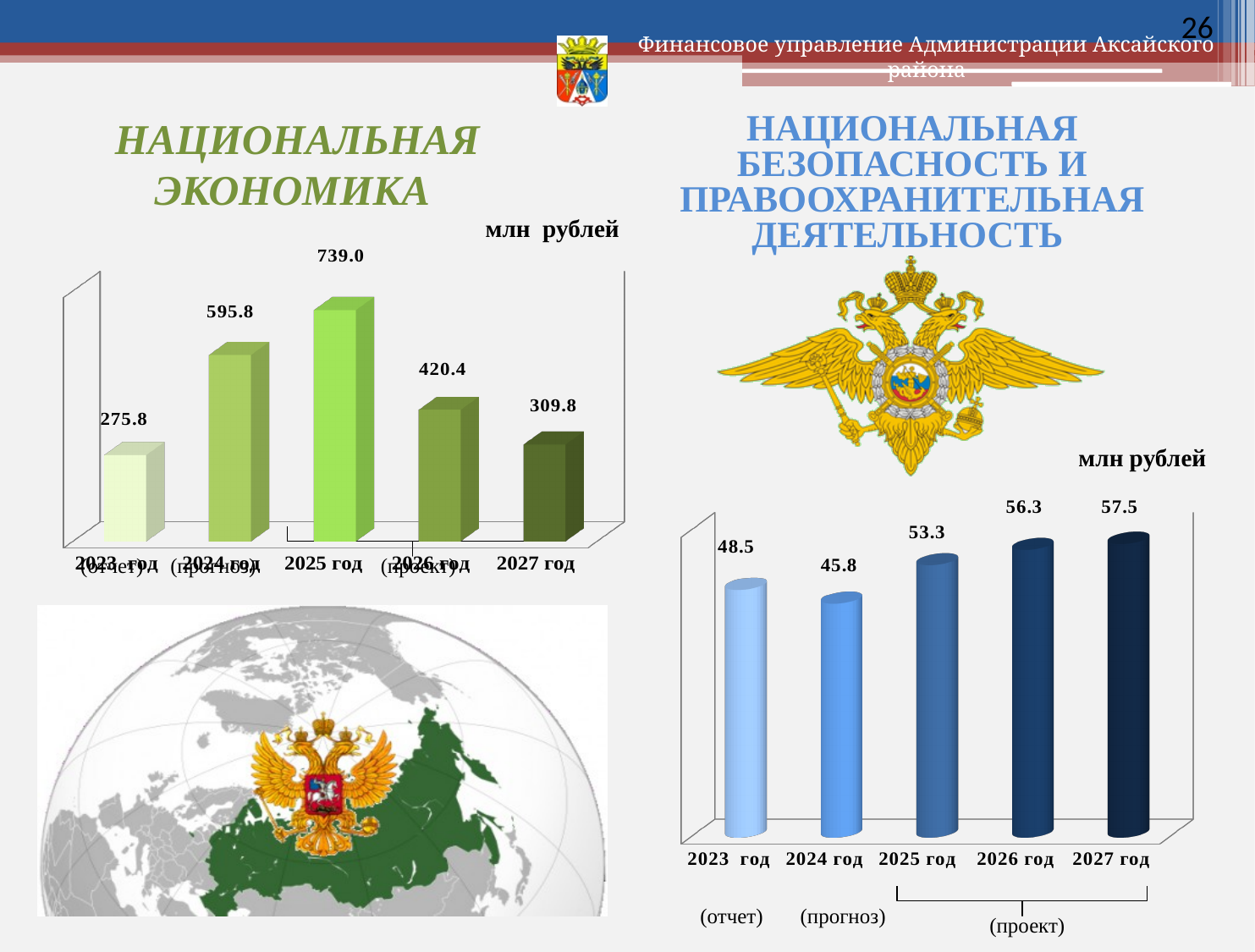
How many bars are in the 'НАЦИОНАЛЬНАЯ ЭКОНОМИКА' chart? 5 In the 'НАЦИОНАЛЬНАЯ БЕЗОПАСНОСТЬ И ПРАВООХРАНИТЕЛЬНАЯ ДЕЯТЕЛЬНОСТЬ' chart, which year has the highest value? 2027 год In the 'НАЦИОНАЛЬНАЯ БЕЗОПАСНОСТЬ И ПРАВООХРАНИТЕЛЬНАЯ ДЕЯТЕЛЬНОСТЬ' chart, what is the value for 2024 год? 45.8 In the 'НАЦИОНАЛЬНАЯ ЭКОНОМИКА' chart, what is the value for 2023 год? 275.8 In the 'НАЦИОНАЛЬНАЯ ЭКОНОМИКА' chart, which year has the lowest value? 2023 год In the 'НАЦИОНАЛЬНАЯ ЭКОНОМИКА' chart, what is the difference between the values for 2025 год and 2024 год? 143.2 In the 'НАЦИОНАЛЬНАЯ БЕЗОПАСНОСТЬ И ПРАВООХРАНИТЕЛЬНАЯ ДЕЯТЕЛЬНОСТЬ' chart, do the values rise or fall from 2024 год to 2027 год? Rise In the 'НАЦИОНАЛЬНАЯ ЭКОНОМИКА' chart, which is larger, the value for 2026 год or 2027 год? 2026 год In the 'НАЦИОНАЛЬНАЯ БЕЗОПАСНОСТЬ И ПРАВООХРАНИТЕЛЬНАЯ ДЕЯТЕЛЬНОСТЬ' chart, what is the difference between the values for 2027 год and 2023 год? 9.0 In the 'НАЦИОНАЛЬНАЯ ЭКОНОМИКА' chart, what is the value for 2025 год? 739.0 What unit is shown for the values in the 'НАЦИОНАЛЬНАЯ БЕЗОПАСНОСТЬ И ПРАВООХРАНИТЕЛЬНАЯ ДЕЯТЕЛЬНОСТЬ' chart? млн рублей What type of chart is used for 'НАЦИОНАЛЬНАЯ ЭКОНОМИКА'? Bar chart